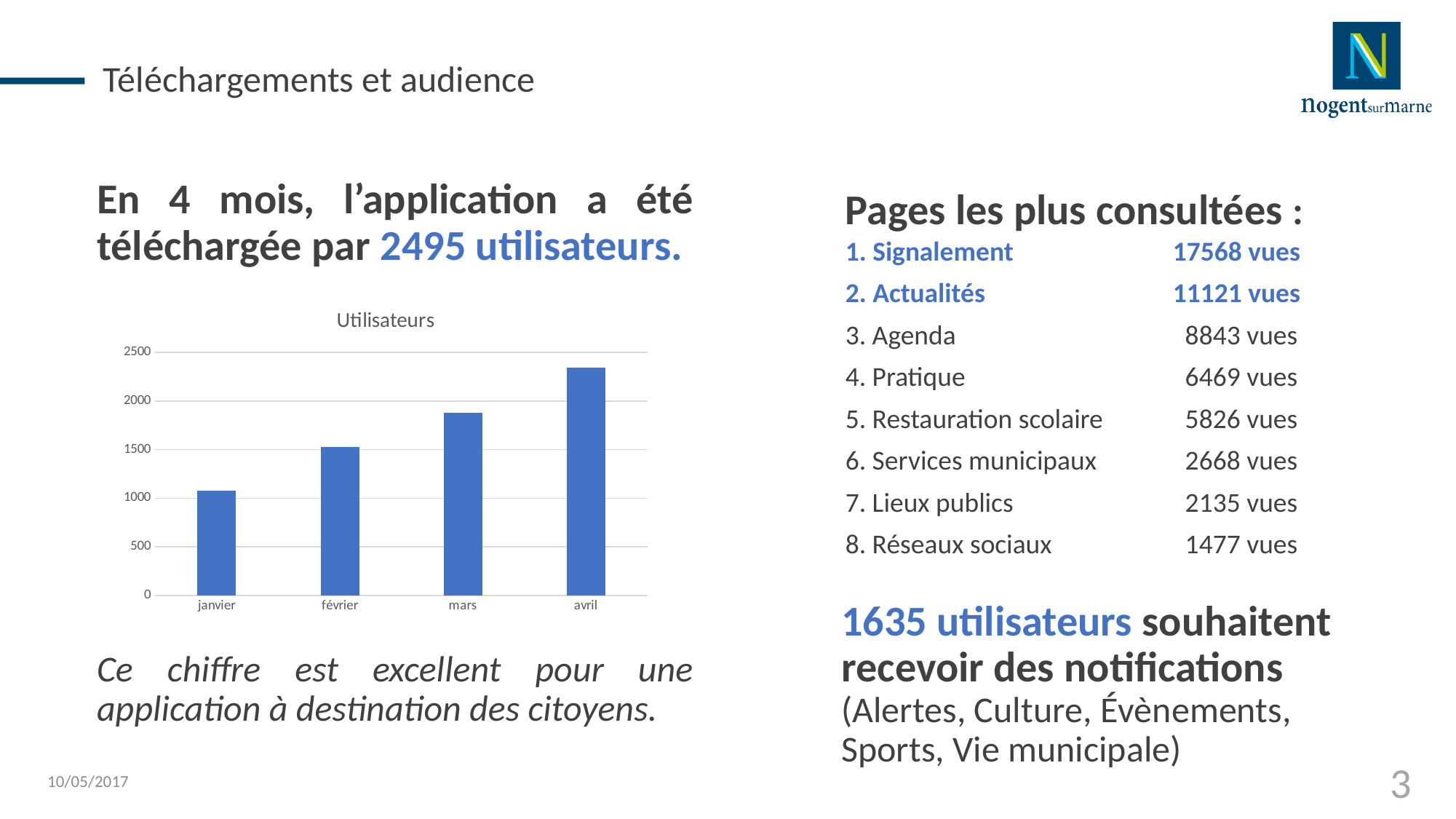
Is the value for janvier greater or less than 1000? greater Which month has the highest value in the chart? avril Is the value for mars greater or less than 2000? less How many months are shown on the x axis of the chart? 4 Is the value for avril greater or less than 2500? less What kind of chart is shown on the slide? bar chart Which is larger, the value for mars or the value for février? mars What is the title of the chart? Utilisateurs Which month has the lowest value in the chart? janvier Do the values rise or fall from janvier to avril? rise